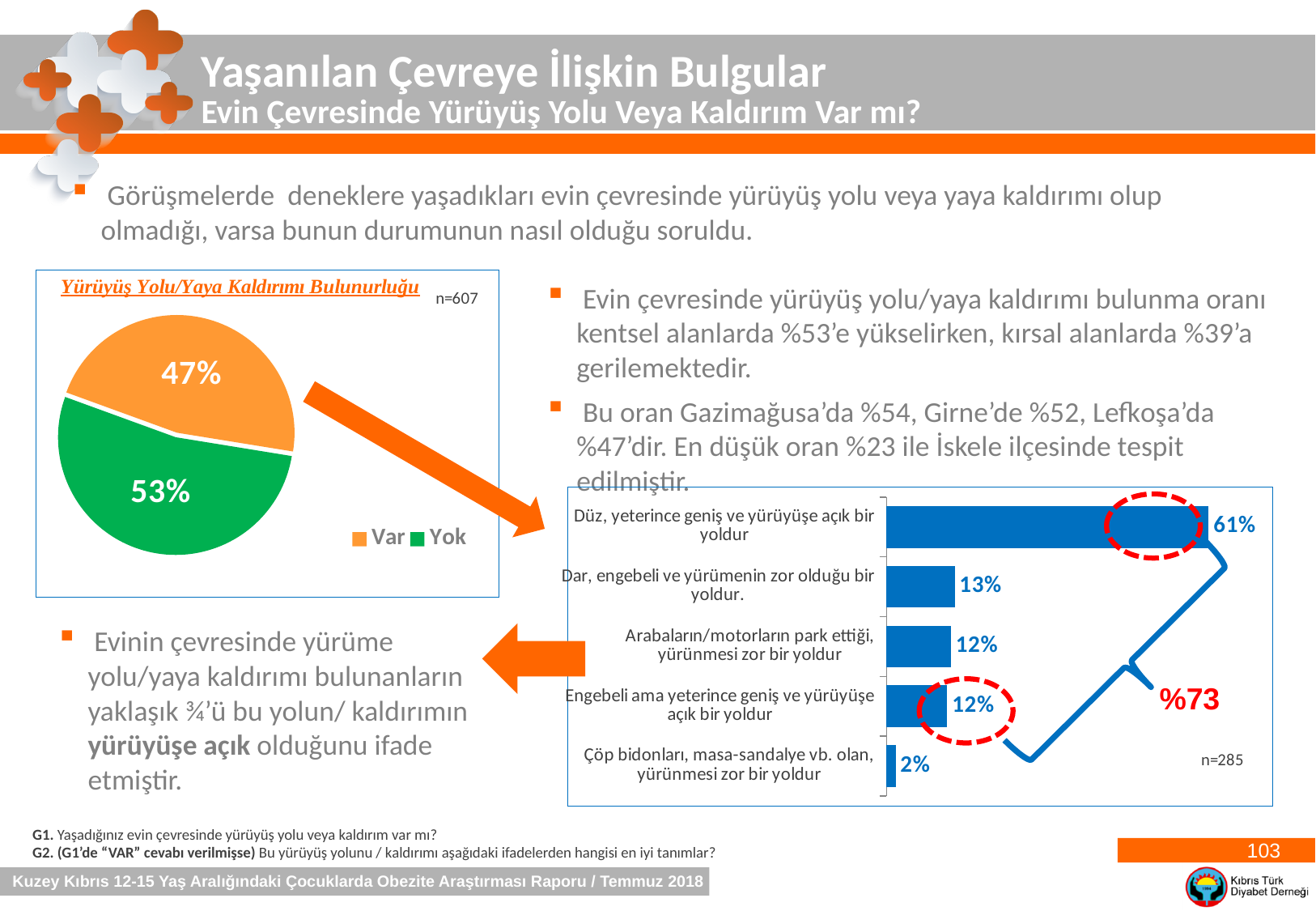
In the bar chart on the lower right, what is the value for "Dar, engebeli ve yürümenin zor olduğu bir yoldur."? 13% In the bar chart on the lower right, which category has the lowest value? Çöp bidonları, masa-sandalye vb. olan, yürünmesi zor bir yoldur In the pie chart titled "Yürüyüş Yolu/Yaya Kaldırımı Bulunurluğu", what share is labelled for "Var"? 47% What kind of chart is the chart titled "Yürüyüş Yolu/Yaya Kaldırımı Bulunurluğu"? Pie chart What kind of chart is the chart on the lower right of the slide? Bar chart In the pie chart titled "Yürüyüş Yolu/Yaya Kaldırımı Bulunurluğu", how many entries does the legend list? 2 In the bar chart on the lower right, how many categories are shown? 5 In the bar chart on the lower right, what is the difference between the values for "Düz, yeterince geniş ve yürüyüşe açık bir yoldur" and "Dar, engebeli ve yürümenin zor olduğu bir yoldur."? 48% In the bar chart on the lower right, what is the value for "Düz, yeterince geniş ve yürüyüşe açık bir yoldur"? 61% In the pie chart titled "Yürüyüş Yolu/Yaya Kaldırımı Bulunurluğu", what colour is the "Var" slice? Orange In the pie chart titled "Yürüyüş Yolu/Yaya Kaldırımı Bulunurluğu", which slice is larger, "Var" or "Yok"? Yok In the pie chart titled "Yürüyüş Yolu/Yaya Kaldırımı Bulunurluğu", what share is labelled for "Yok"? 53%